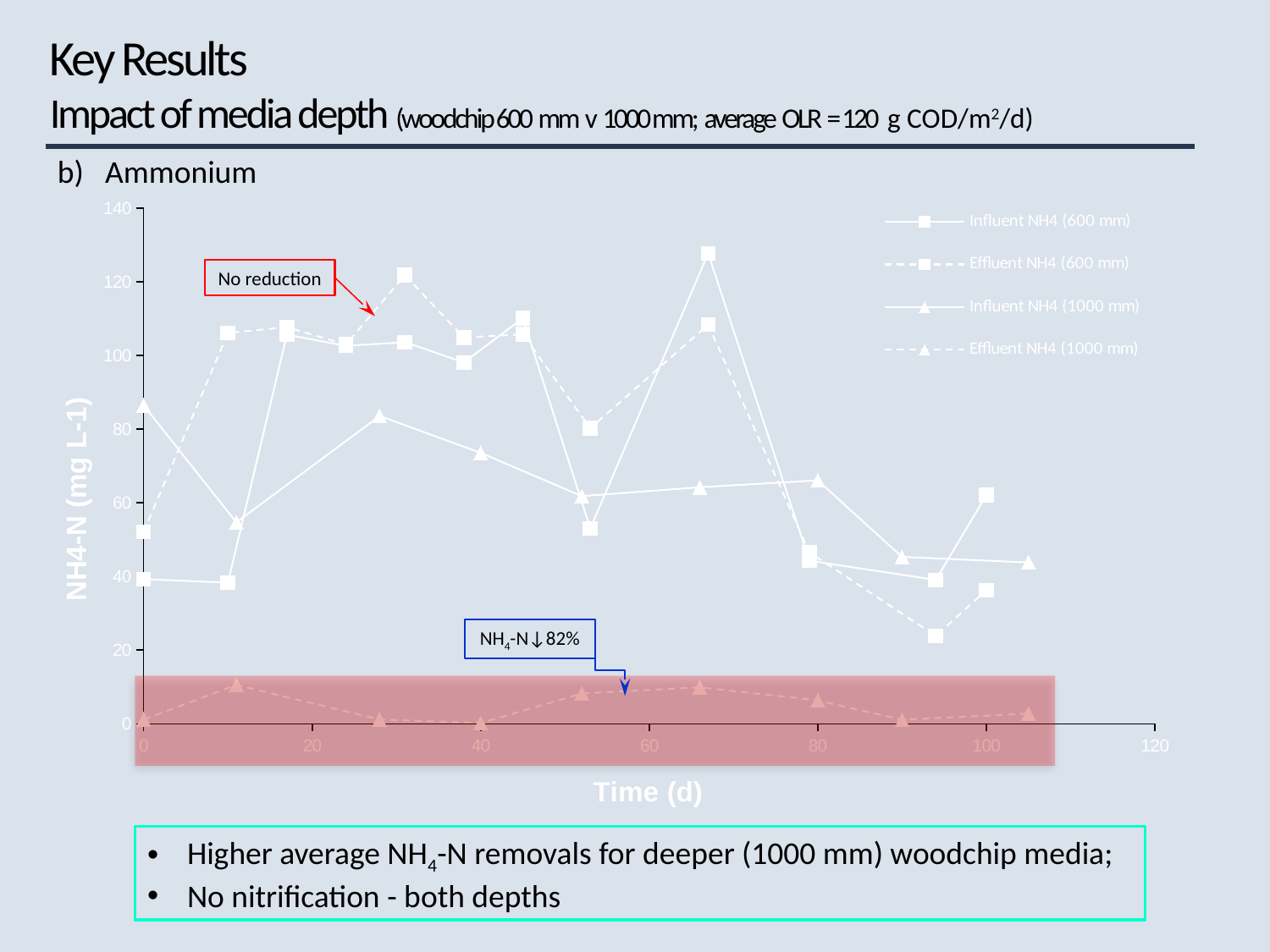
Is the peak value of Influent NH4 (600 mm) greater or less than 120? greater What kind of chart is shown on the slide? line chart Which series has the lowest values across the whole time period? Effluent NH4 (1000 mm) Is the value for Influent NH4 (1000 mm) at day 0 greater or less than 80? greater How many series does the legend list? 4 Which series reaches the highest value on the chart? Influent NH4 (600 mm) Are the values for Effluent NH4 (1000 mm) greater or less than 20 throughout the period? less Does Influent NH4 (1000 mm) rise or fall between day 40 and day 100? fall What percentage reduction in NH4-N is stated in the annotation box near the bottom of the chart? 82% What are the four series listed in the legend? Influent NH4 (600 mm), Effluent NH4 (600 mm), Influent NH4 (1000 mm), Effluent NH4 (1000 mm) At day 0, which is larger: Influent NH4 (1000 mm) or Influent NH4 (600 mm)? Influent NH4 (1000 mm) Around day 80, which is larger: Influent NH4 (1000 mm) or Effluent NH4 (1000 mm)? Influent NH4 (1000 mm)